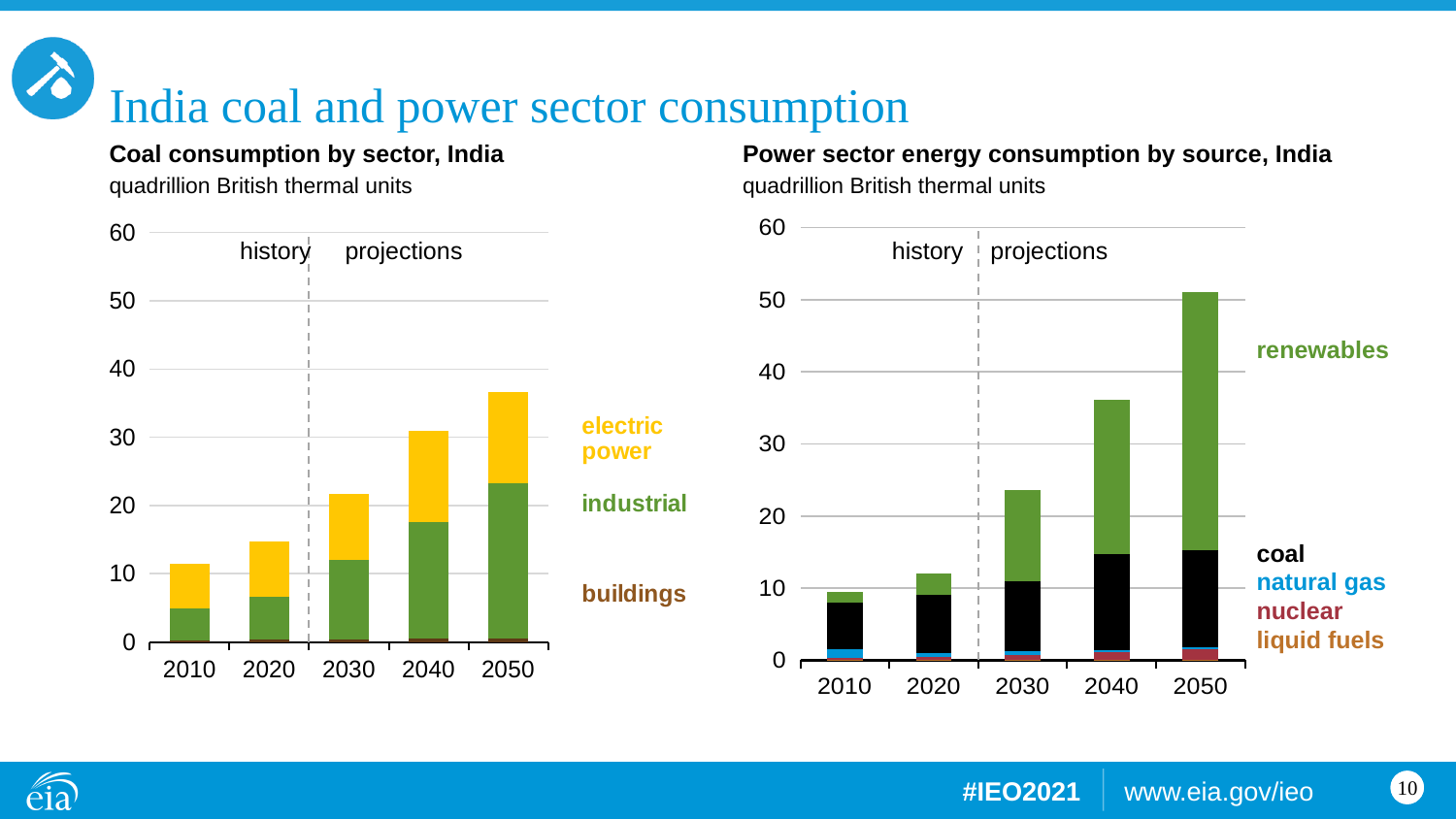
How many series does the 'Power sector energy consumption by source, India' chart show? 5 In the 'Coal consumption by sector, India' chart, which year has the highest total coal consumption? 2050 In the 'Coal consumption by sector, India' chart, do total values rise or fall from 2010 to 2050? rise How many years are plotted on the x axis of the 'Coal consumption by sector, India' chart? 5 In the 'Coal consumption by sector, India' chart, which sector is shown in yellow? electric power How many series does the 'Coal consumption by sector, India' chart show? 3 What kind of chart is the 'Coal consumption by sector, India' chart? stacked bar chart In the 'Power sector energy consumption by source, India' chart, which year has the lowest total consumption? 2010 In the 'Power sector energy consumption by source, India' chart, is the total for 2050 larger than the total for 2040? yes In the 'Coal consumption by sector, India' chart, is the total for 2050 greater or less than 30? greater In the 'Power sector energy consumption by source, India' chart, is the total for 2030 greater or less than 20? greater What unit is used on the y axis of the 'Power sector energy consumption by source, India' chart? quadrillion British thermal units